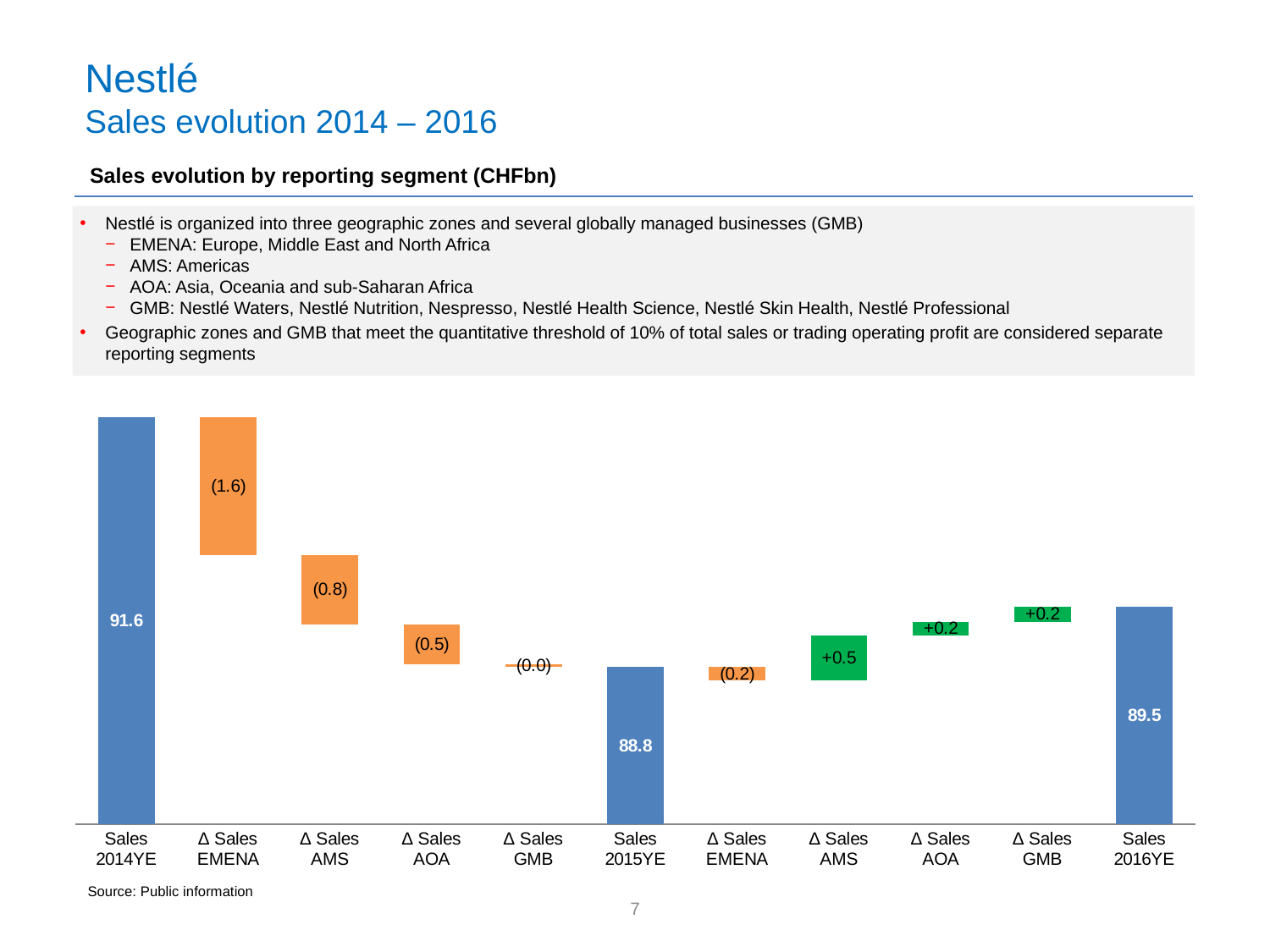
What is the value of the Sales 2014YE bar? 91.6 How many bars are plotted along the x axis of the chart? 11 What is the value of the Sales 2016YE bar? 89.5 What is the value shown for Δ Sales EMENA between Sales 2015YE and Sales 2016YE? (0.2) What is the value shown for Δ Sales EMENA between Sales 2014YE and Sales 2015YE? (1.6) What is the difference between the Sales 2014YE and Sales 2015YE values? 2.8 Which of the three year-end sales bars (2014YE, 2015YE, 2016YE) is the highest? Sales 2014YE What is the value of the Sales 2015YE bar? 88.8 What is the value shown for Δ Sales GMB between Sales 2014YE and Sales 2015YE? (0.0) What is the value shown for Δ Sales AMS between Sales 2015YE and Sales 2016YE? +0.5 Which of the three year-end sales bars (2014YE, 2015YE, 2016YE) is the lowest? Sales 2015YE What kind of chart is shown on the slide? Waterfall bar chart